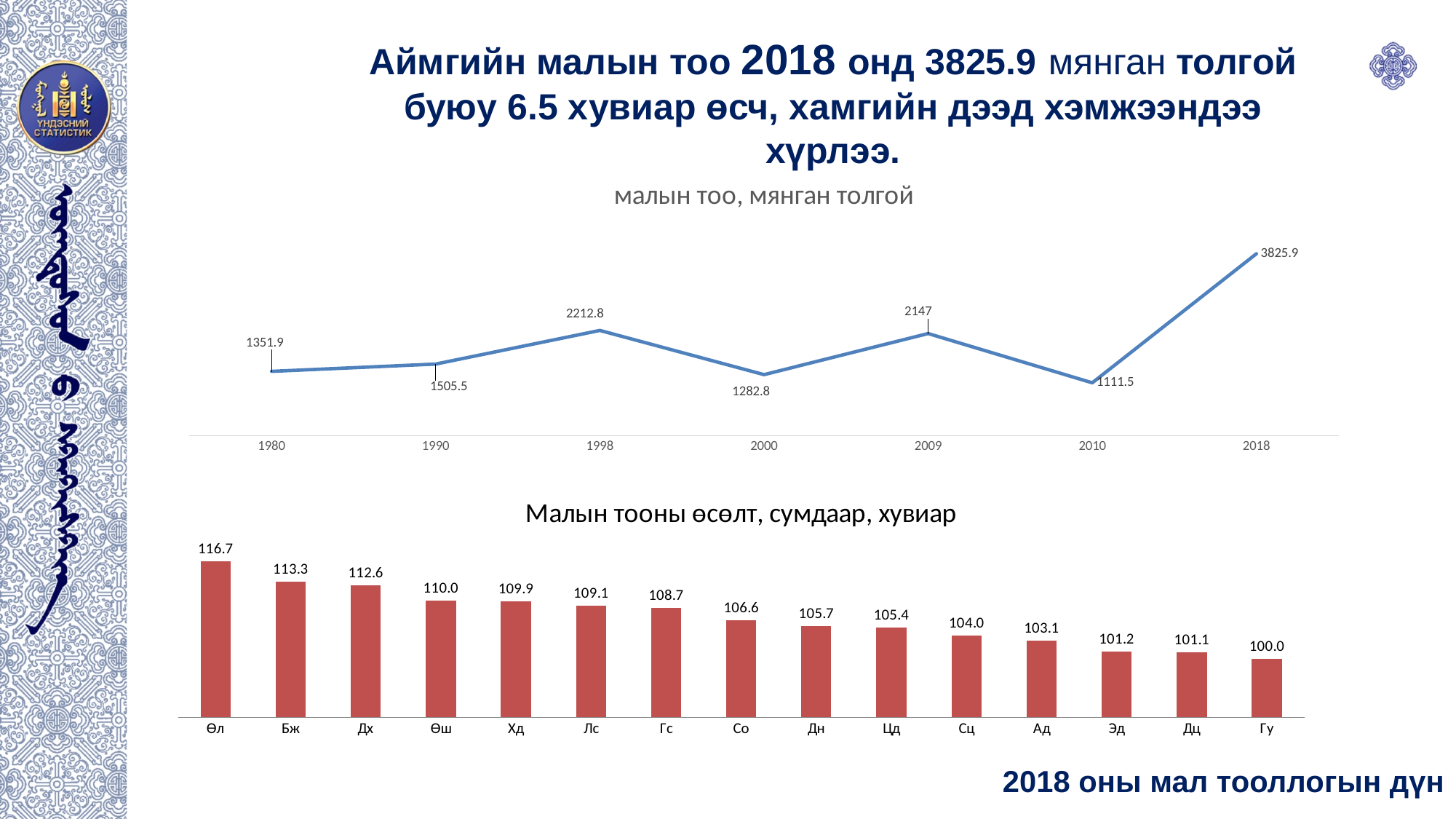
What kind of chart is the bottom chart 'Малын тооны өсөлт, сумдаар, хувиар'? bar chart In the top chart 'малын тоо, мянган толгой', how many data points are plotted? 7 In the bottom chart 'Малын тооны өсөлт, сумдаар, хувиар', how many categories are shown? 15 What kind of chart is the top chart 'малын тоо, мянган толгой'? line chart In the top chart 'малын тоо, мянган толгой', which year has the lowest value? 2010 In the bottom chart 'Малын тооны өсөлт, сумдаар, хувиар', what is the value for Өл? 116.7 In the top chart 'малын тоо, мянган толгой', what is the value for 2018? 3825.9 In the bottom chart 'Малын тооны өсөлт, сумдаар, хувиар', which category has the lowest value? Гу In the bottom chart 'Малын тооны өсөлт, сумдаар, хувиар', what is the difference between the values for Өл and Бж? 3.4 In the top chart 'малын тоо, мянган толгой', which is larger, the value for 1998 or the value for 2009? 1998 In the top chart 'малын тоо, мянган толгой', what is the difference between the 2018 value and the 2010 value? 2714.4 In the top chart 'малын тоо, мянган толгой', what is the value for 1998? 2212.8